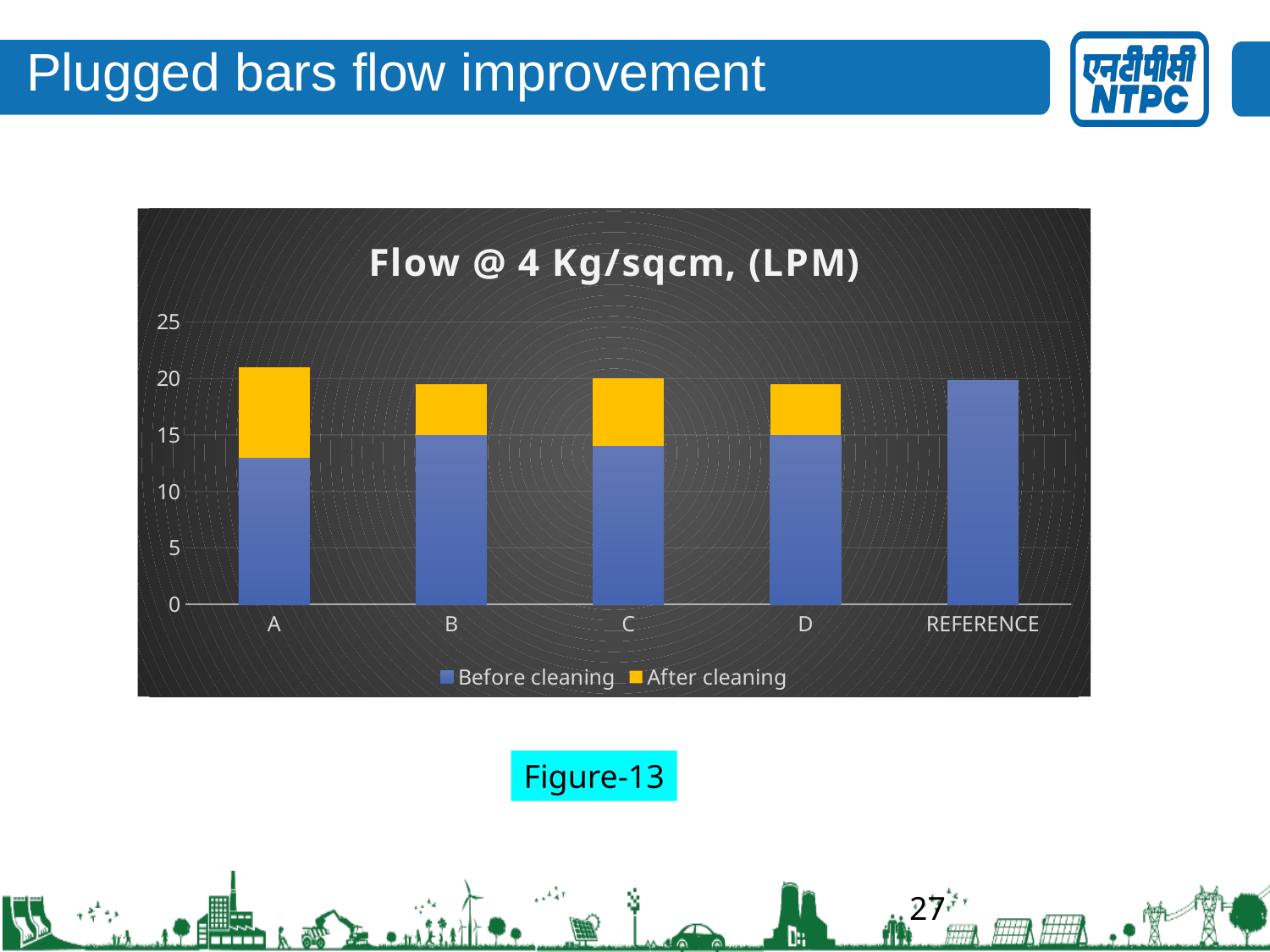
Which category has no After cleaning segment in its bar? REFERENCE Is the Before cleaning value for A greater or less than 15? less Is the Before cleaning value for REFERENCE greater or less than 15? greater How many categories are shown on the x axis of the chart? 5 What is the title of the chart? Flow @ 4 Kg/sqcm, (LPM) Which category has the largest After cleaning segment? A Which is larger, the Before cleaning value for REFERENCE or for A? REFERENCE What kind of chart is shown on the slide? Stacked bar chart Is the Before cleaning value for A greater or less than 10? greater How many series does the chart legend list? 2 Which category has the largest Before cleaning value? REFERENCE What are the two series named in the chart legend? Before cleaning and After cleaning